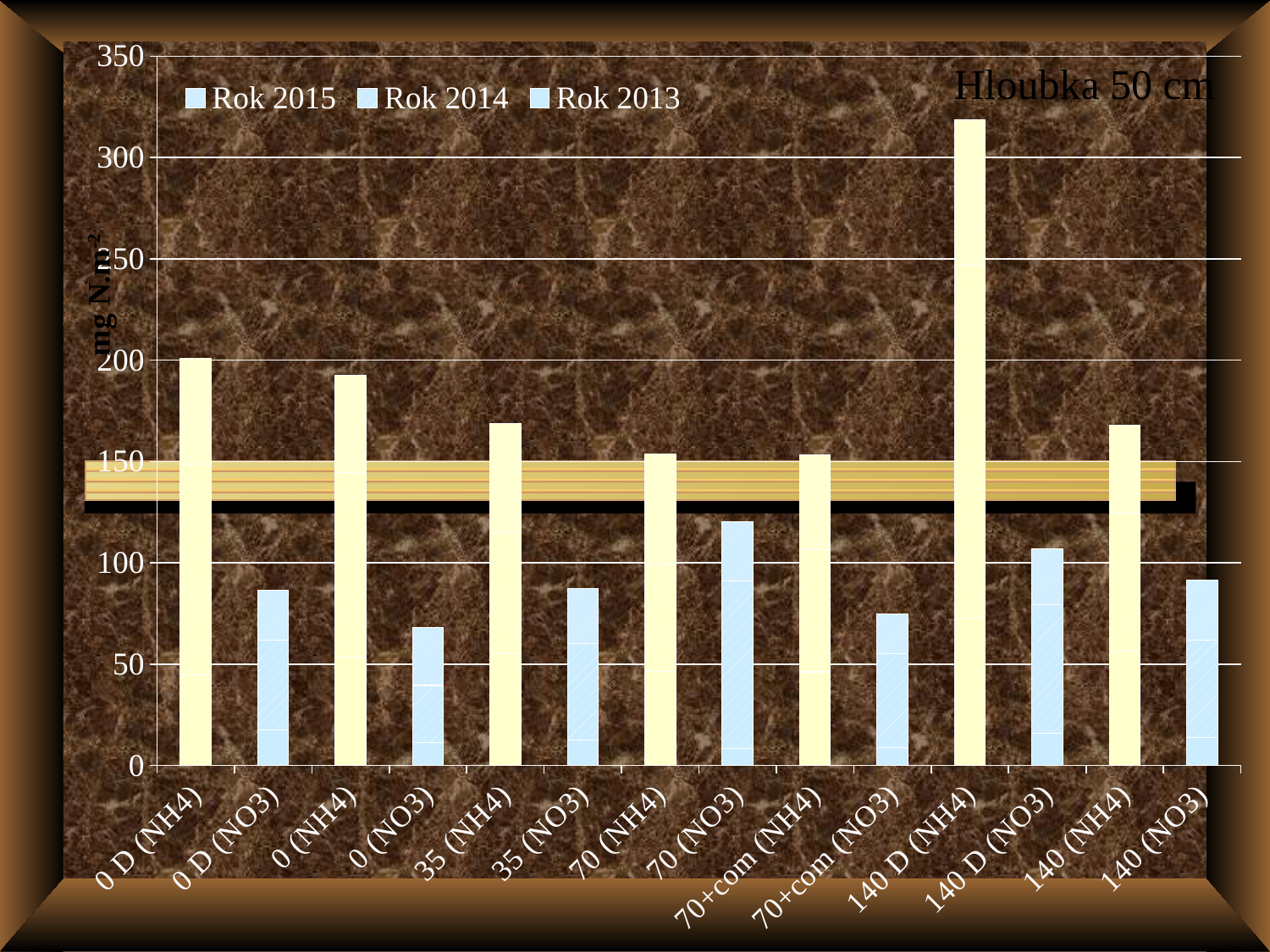
Which has the larger total bar, 70 (NO3) or 70+com (NO3)? 70 (NO3) Is the total value for 70 (NO3) greater or less than 100? greater Which has the larger total bar, 0 D (NH4) or 0 D (NO3)? 0 D (NH4) Is the total value for 140 D (NH4) greater or less than 300? greater What is the title shown on the chart? Hloubka 50 cm How many series does the legend list? 3 Is the total value for 0 D (NH4) greater or less than 150? greater What kind of chart is shown on the slide? bar chart Which category has the highest total bar? 140 D (NH4) How many categories are shown on the x axis? 14